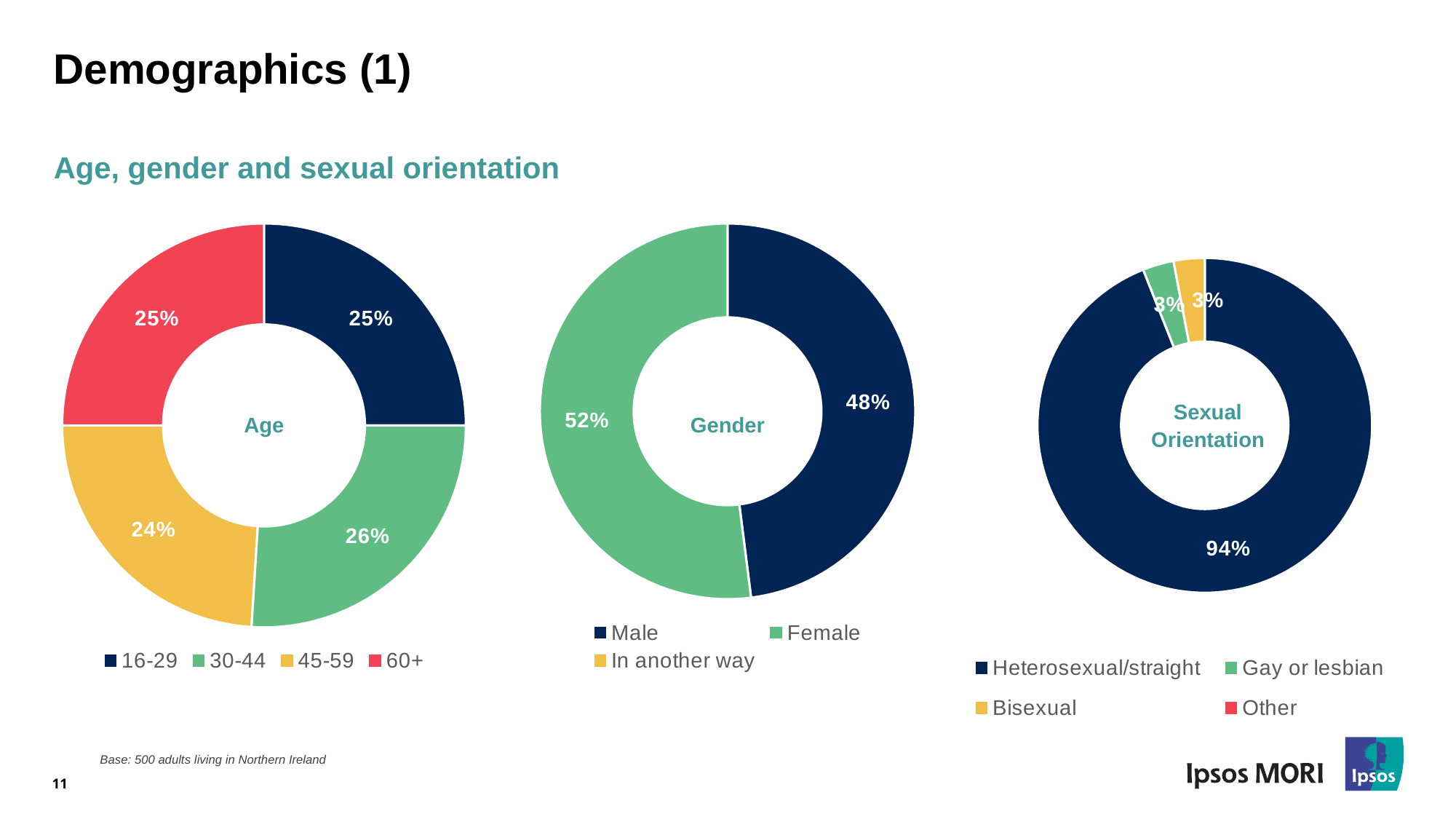
How many entries does the legend of the Sexual Orientation chart list? 4 In the Age chart, which age group has the largest share? 30-44 In the Gender chart, what percentage is shown for Female? 52% In the Age chart, what is the difference between the 30-44 share and the 45-59 share? 2% In the Gender chart, what is the difference between the Female and Male shares? 4% In the Age chart, what percentage is shown for the 45-59 group? 24% In the Sexual Orientation chart, what percentage is shown for Heterosexual/straight? 94% What type of chart is the Age chart? Donut (pie) chart In the Gender chart, which is larger, Male or Female? Female In the Age chart, what percentage is shown for the 30-44 group? 26% In the Sexual Orientation chart, what percentage is shown for Bisexual? 3% In the Age chart, which age group has the smallest share? 45-59